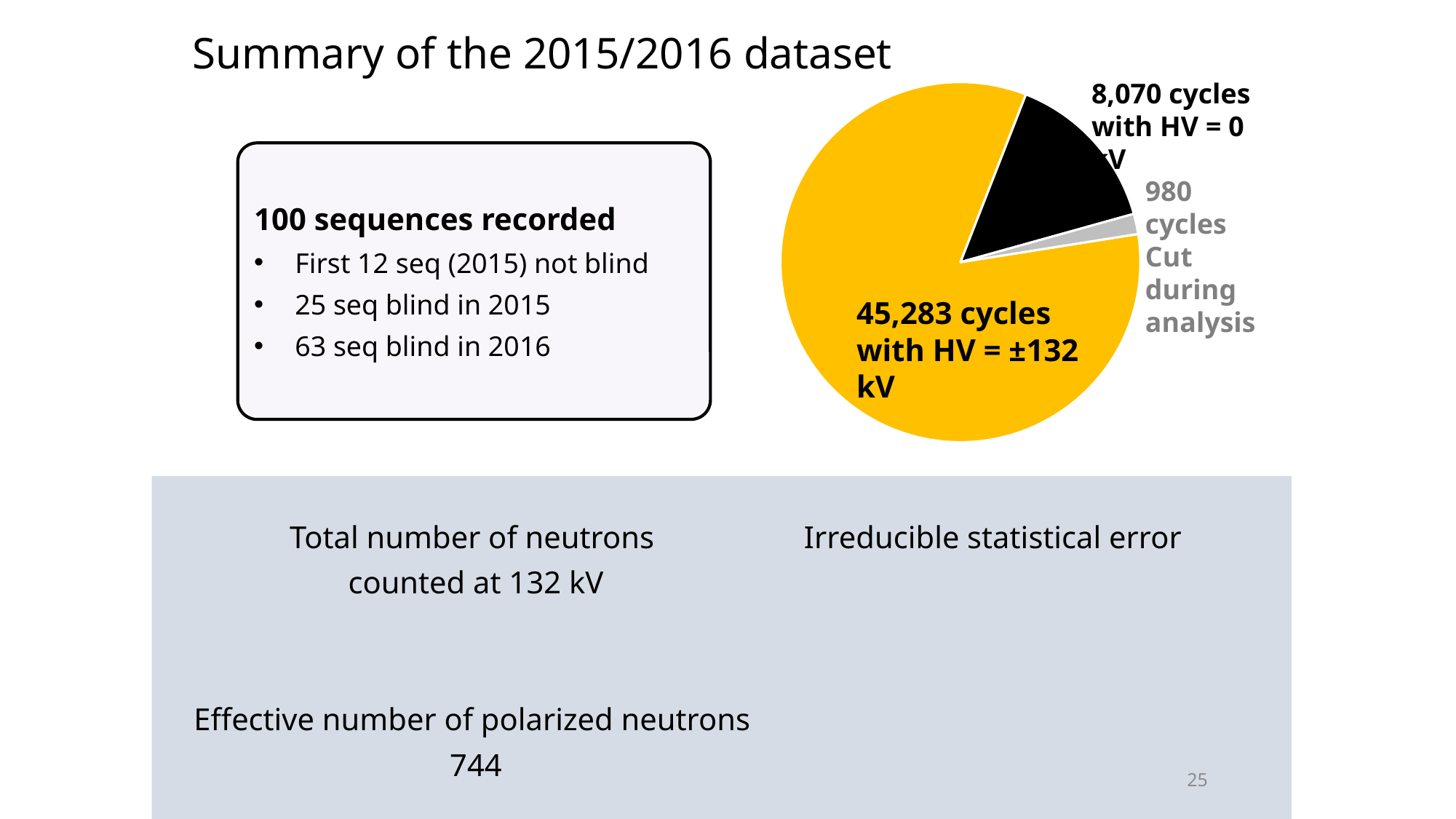
What colour is the slice for cycles with HV = ±132 kV in the pie chart? yellow Which slice of the pie chart is the largest? 45,283 cycles with HV = ±132 kV How many cycles were recorded with HV = ±132 kV according to the pie chart? 45,283 cycles What kind of chart is shown on the slide? pie chart How many slices does the pie chart have? 3 Which is larger: the number of cycles with HV = 0 kV or the number of cycles cut during analysis? cycles with HV = 0 kV What is the difference between the number of cycles with HV = 0 kV and the number of cycles cut during analysis? 7,090 What is the total number of cycles represented in the pie chart? 54,333 Which slice of the pie chart is the smallest? 980 cycles cut during analysis How many cycles were recorded with HV = 0 kV according to the pie chart? 8,070 cycles How many cycles were cut during analysis according to the pie chart? 980 cycles What is the difference between the number of cycles with HV = ±132 kV and the number of cycles with HV = 0 kV? 37,213